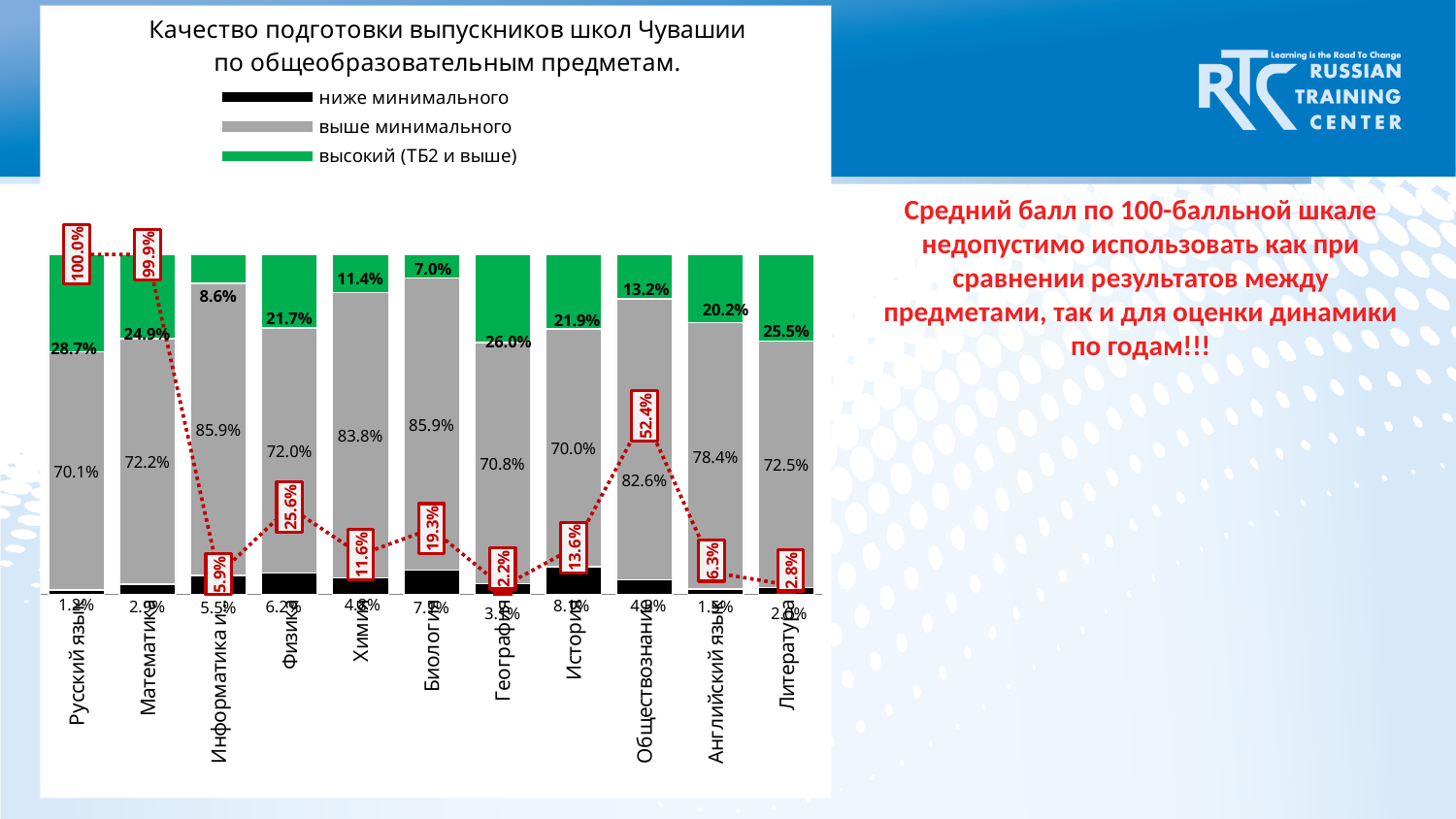
How many subjects (categories) are shown along the x axis of the chart? 11 What colour does the legend use for the 'высокий (ТБ2 и выше)' series? Green What is the value of the 'высокий (ТБ2 и выше)' segment for Английский язык? 20.2% What is the value of the 'выше минимального' segment for Литература? 72.5% What is the value of the 'выше минимального' segment for Информатика? 85.9% Which has the larger 'выше минимального' value, Химия or Обществознание? Химия What is the value of the 'высокий (ТБ2 и выше)' segment for Русский язык? 28.7% Which subject has the lowest 'высокий (ТБ2 и выше)' value? Биология Which subject has the highest 'высокий (ТБ2 и выше)' value? Русский язык What is the difference between the 'выше минимального' values for Информатика and Русский язык? 15.8 percentage points What kind of chart is shown on the slide? Combination chart: stacked bar chart with a line How many series does the chart legend list? 3